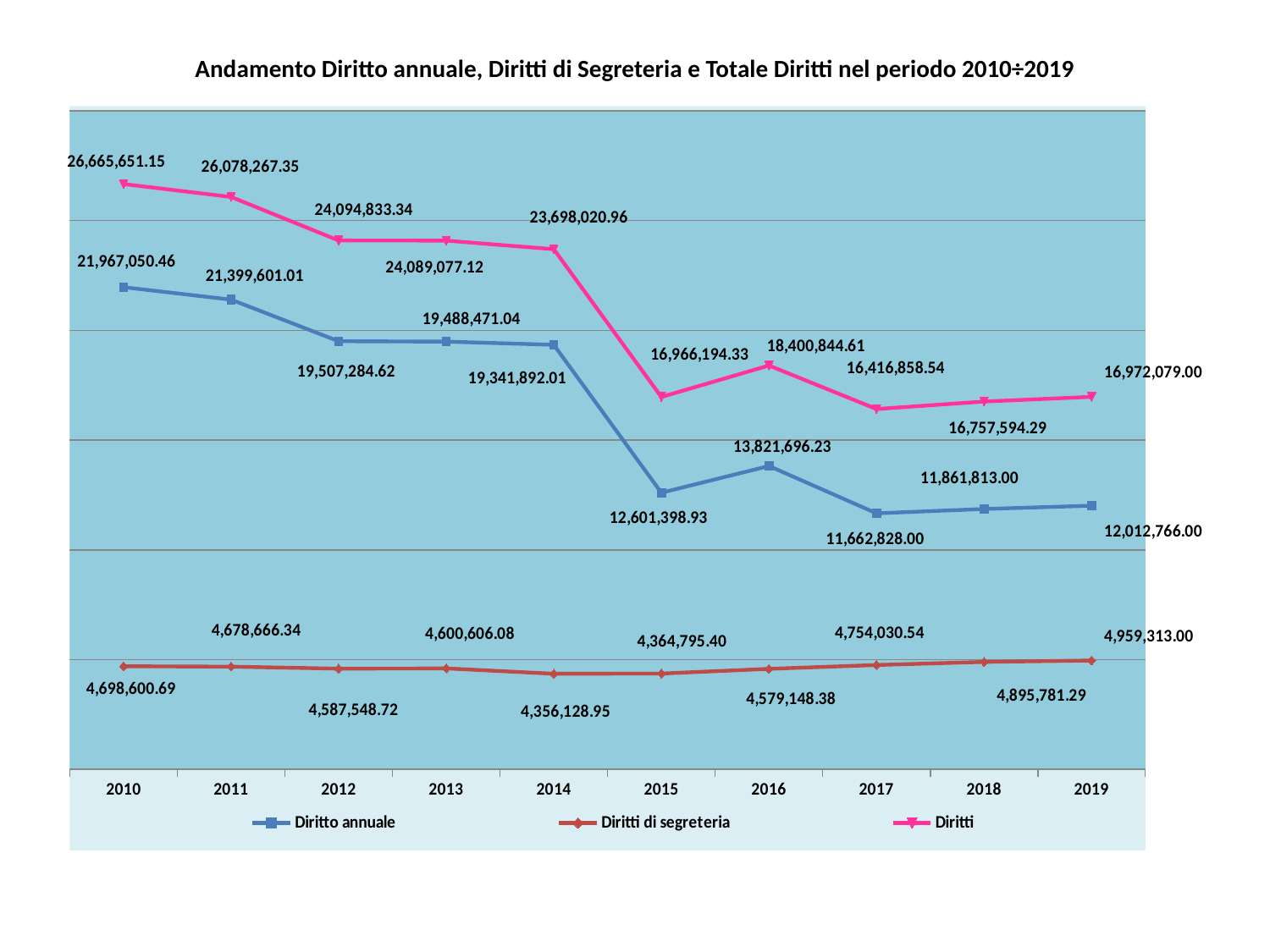
What is the difference between Diritti and Diritto annuale in 2010? 4,698,600.69 In which year is Diritti highest? 2010 In which year is Diritto annuale lowest? 2017 What is the value of Diritto annuale in 2010? 21,967,050.46 What kind of chart is shown? line chart By how much did Diritto annuale fall from 2010 to 2019? 9,954,284.46 How many years are shown on the x axis? 10 What is the value of Diritti in 2019? 16,972,079.00 Which is larger, Diritto annuale in 2016 or Diritto annuale in 2015? 2016 What is the value of Diritti di segreteria in 2014? 4,356,128.95 In which year is Diritti di segreteria highest? 2019 How many series does the legend list? 3